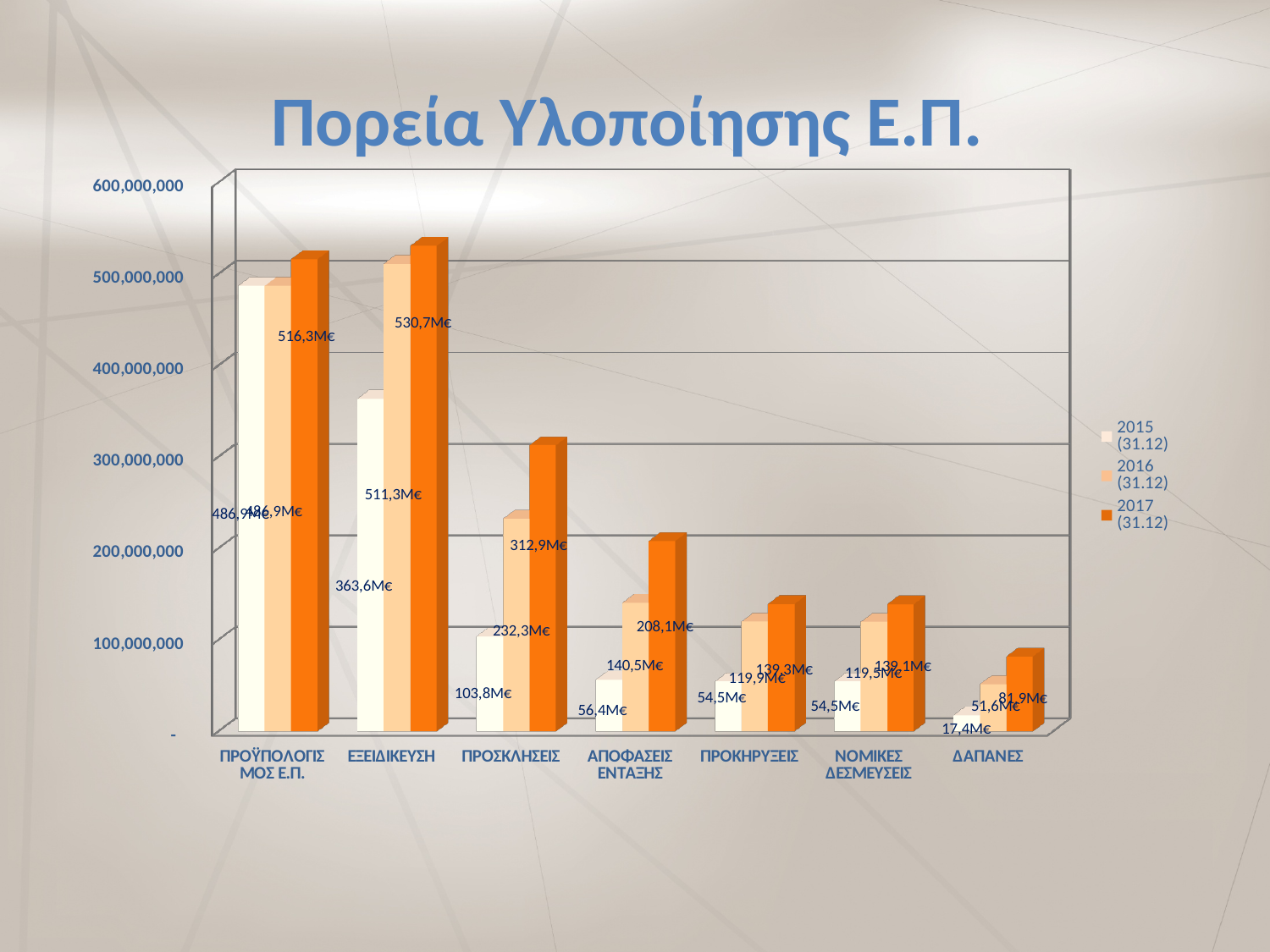
What is the value for ΔΑΠΑΝΕΣ in the 2015 (31.12) series? 17,4M€ In the 2017 (31.12) series, which is larger: ΑΠΟΦΑΣΕΙΣ ΕΝΤΑΞΗΣ or ΠΡΟΚΗΡΥΞΕΙΣ? ΑΠΟΦΑΣΕΙΣ ΕΝΤΑΞΗΣ What is the value for ΕΞΕΙΔΙΚΕΥΣΗ in the 2017 (31.12) series? 530,7M€ Is the 2015 (31.12) value for ΕΞΕΙΔΙΚΕΥΣΗ greater or less than 400,000,000? less How many series does the legend list? 3 Which category has the lowest value in the 2017 (31.12) series? ΔΑΠΑΝΕΣ What is the difference between the 2017 (31.12) and 2015 (31.12) values for ΠΡΟΣΚΛΗΣΕΙΣ? 209,0M€ What kind of chart is shown on the slide? bar chart Which category has the highest value in the 2017 (31.12) series? ΕΞΕΙΔΙΚΕΥΣΗ What is the title of the chart? Πορεία Υλοποίησης Ε.Π. What is the value for ΠΡΟΣΚΛΗΣΕΙΣ in the 2016 (31.12) series? 232,3M€ How many categories are shown on the x axis? 7